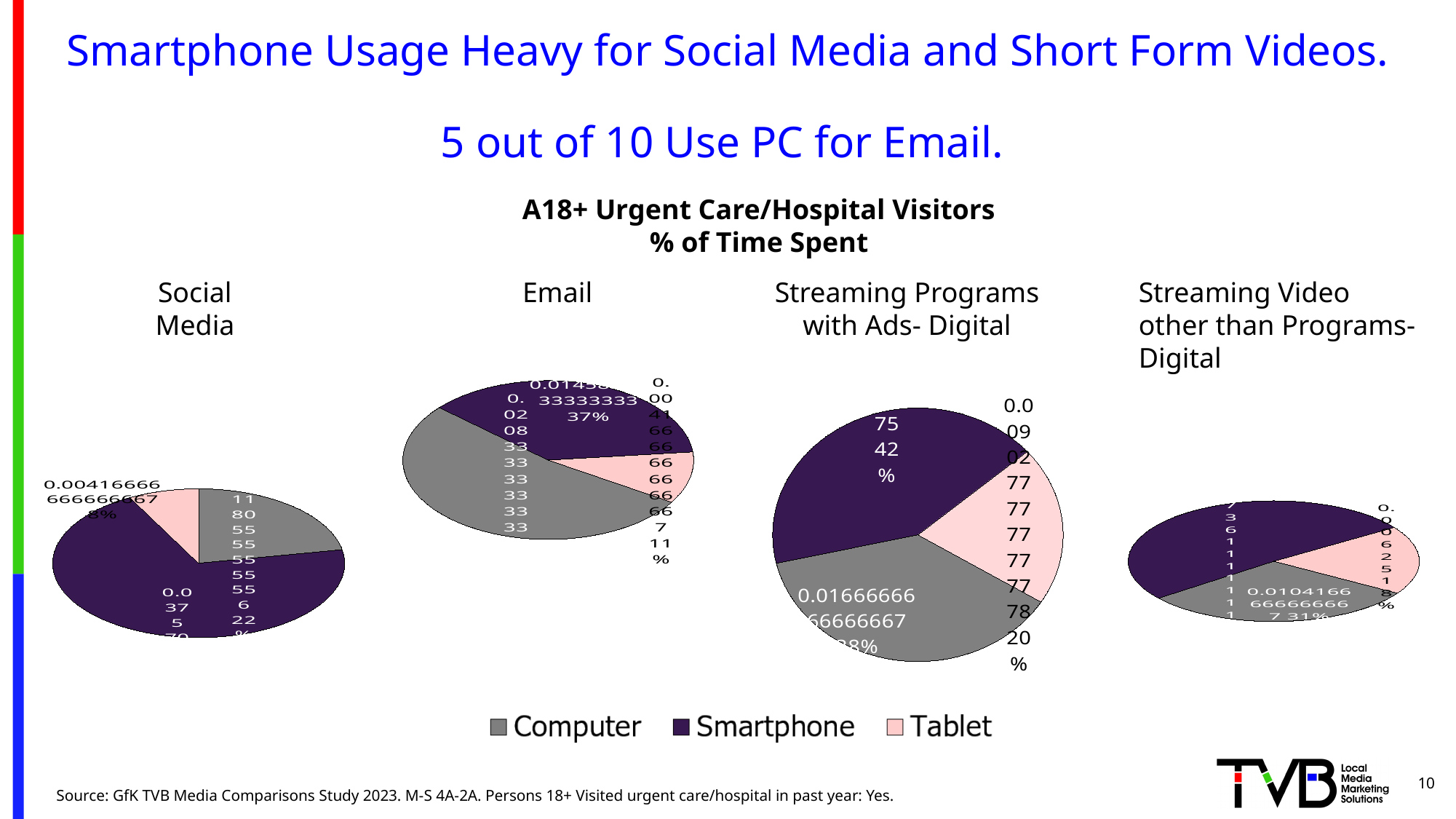
In the Streaming Video other than Programs- Digital pie chart, which device has the smallest share of time spent? Tablet How many series does the legend list? 3 How many pie charts are on the slide? 4 In the Social Media pie chart, what share of time spent is on Tablet? 8% In the Streaming Programs with Ads- Digital pie chart, what share of time spent is on Tablet? 20% What are the three legend entries? Computer, Smartphone, Tablet In the Email pie chart, what share of time spent is on Tablet? 11% In the Email pie chart, what share of time spent is on Smartphone? 37% In the Email pie chart, how many percentage points larger is the Smartphone share than the Tablet share? 26 In the Email pie chart, which device has the largest share of time spent? Computer What kind of charts are shown on the slide? Pie charts In the Social Media pie chart, which device has the largest share of time spent? Smartphone